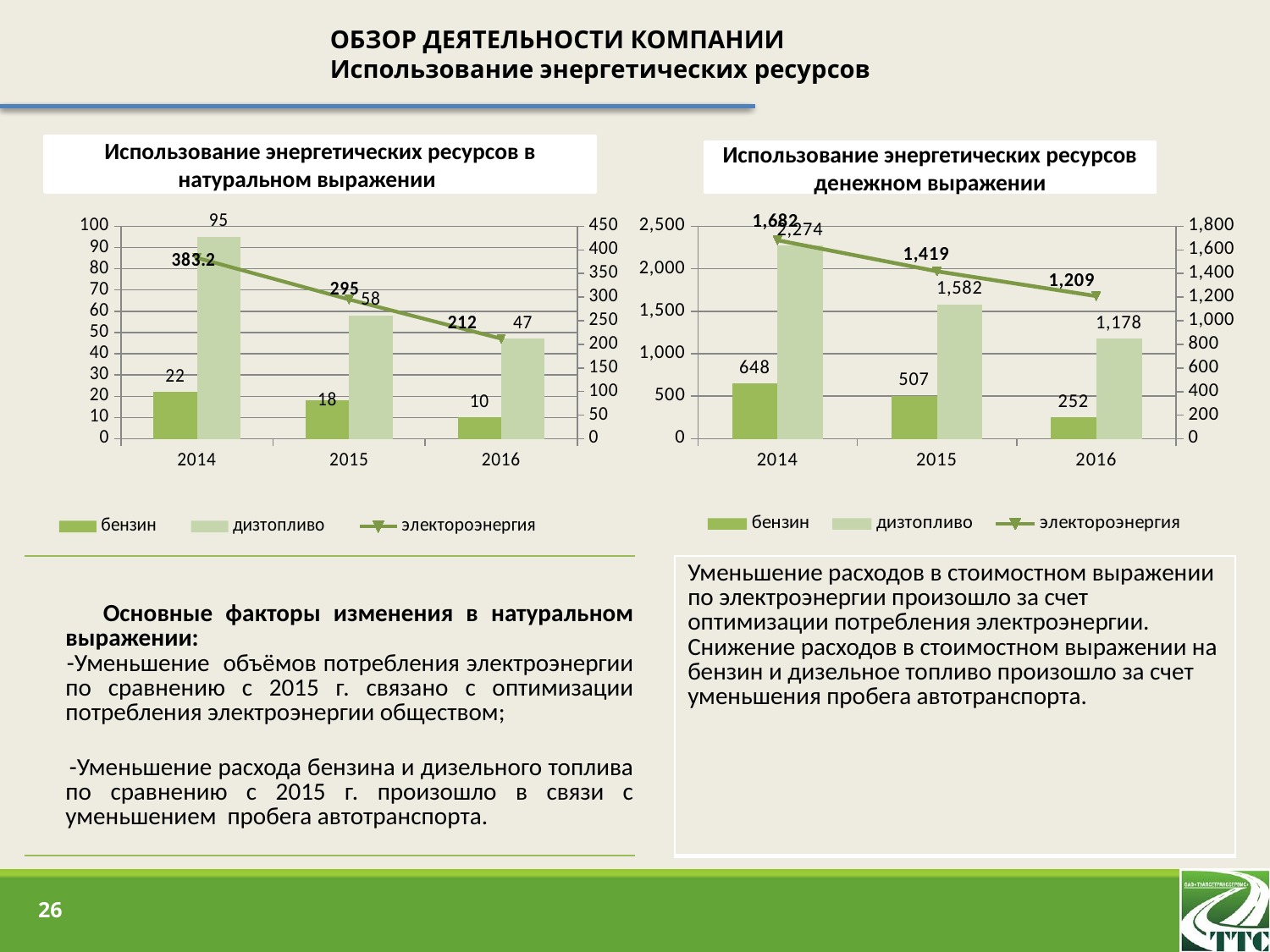
In the chart 'Использование энергетических ресурсов в натуральном выражении', does the value for дизтопливо rise or fall from 2014 to 2016? fall In the chart 'Использование энергетических ресурсов в натуральном выражении', what is the value for бензин in 2016? 10 In the chart 'Использование энергетических ресурсов в натуральном выражении', in which year is бензин lowest? 2016 In the chart 'Использование энергетических ресурсов в натуральном выражении', what is the value for дизтопливо in 2014? 95 In the chart 'Использование энергетических ресурсов денежном выражении', in which year is бензин highest? 2014 In the chart 'Использование энергетических ресурсов денежном выражении', what is the difference between бензин in 2014 and 2016? 396 How many series does the legend of the chart 'Использование энергетических ресурсов денежном выражении' list? 3 In the chart 'Использование энергетических ресурсов денежном выражении', which is larger in 2016: дизтопливо or бензин? дизтопливо In the chart 'Использование энергетических ресурсов денежном выражении', what is the value for дизтопливо in 2015? 1,582 In the chart 'Использование энергетических ресурсов в натуральном выражении', what is the value for электороэнергия in 2015? 295 In the chart 'Использование энергетических ресурсов в натуральном выражении', what is the difference between дизтопливо in 2014 and 2015? 37 In the chart 'Использование энергетических ресурсов денежном выражении', what is the value for электороэнергия in 2016? 1,209